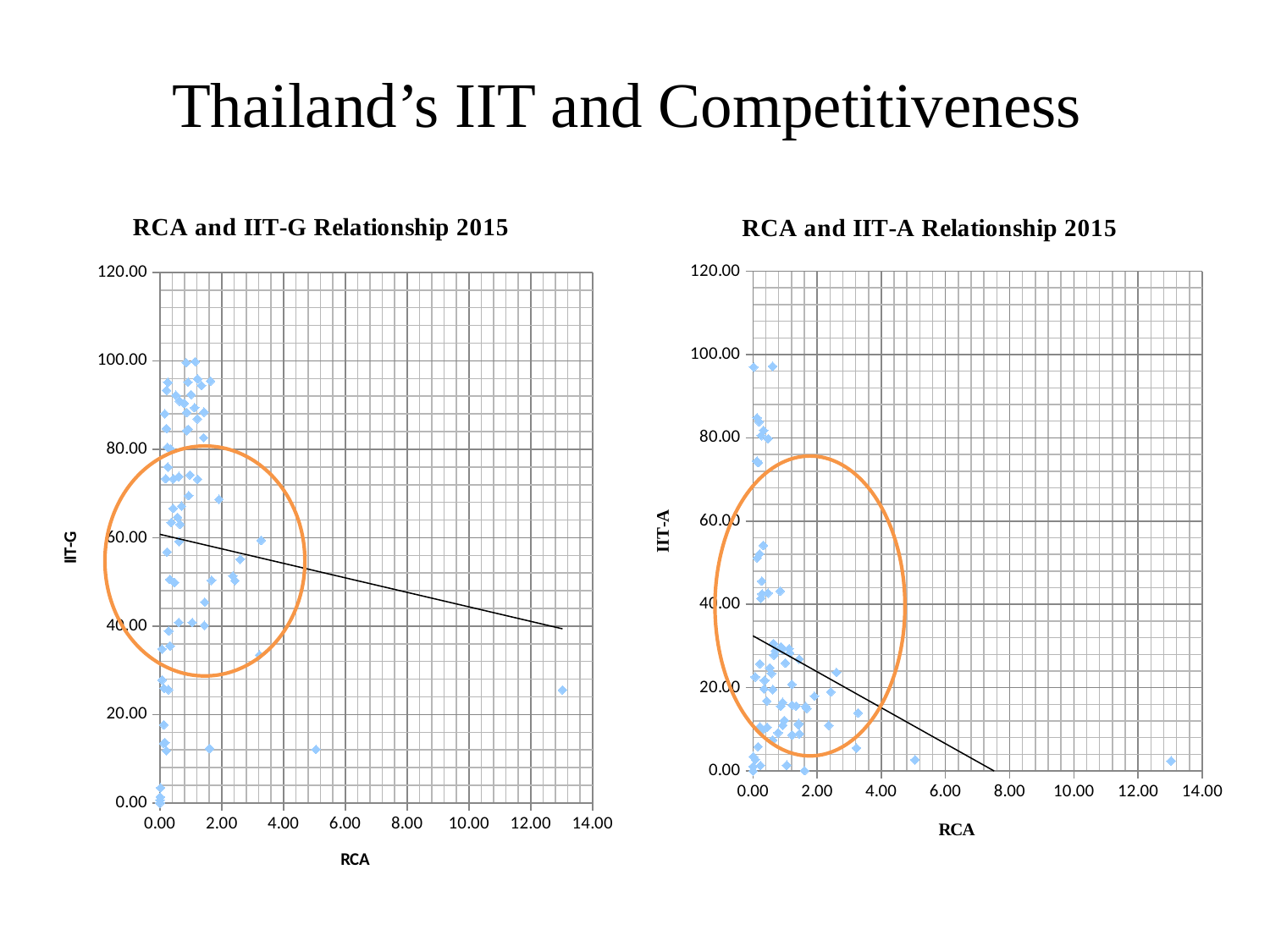
Which chart has points reaching higher on the y axis, 'RCA and IIT-G Relationship 2015' or 'RCA and IIT-A Relationship 2015'? RCA and IIT-G Relationship 2015 In the 'RCA and IIT-A Relationship 2015' chart, are the highest points on the y axis greater or less than 80.00? greater In the 'RCA and IIT-G Relationship 2015' chart, is the highest plotted IIT-G value greater or less than 80.00? greater In the 'RCA and IIT-A Relationship 2015' chart, is the IIT-A value of the point with the highest RCA (around 13) greater or less than 20.00? less What is the label of the y axis in the 'RCA and IIT-A Relationship 2015' chart? IIT-A What is the maximum value shown on the x axis of the 'RCA and IIT-G Relationship 2015' chart? 14.00 What kind of chart is the 'RCA and IIT-G Relationship 2015' chart? scatter chart In the 'RCA and IIT-G Relationship 2015' chart, does the fitted trend line rise or fall as RCA increases? fall In the 'RCA and IIT-A Relationship 2015' chart, does the fitted trend line rise or fall as RCA increases? fall What kind of chart is the 'RCA and IIT-A Relationship 2015' chart? scatter chart